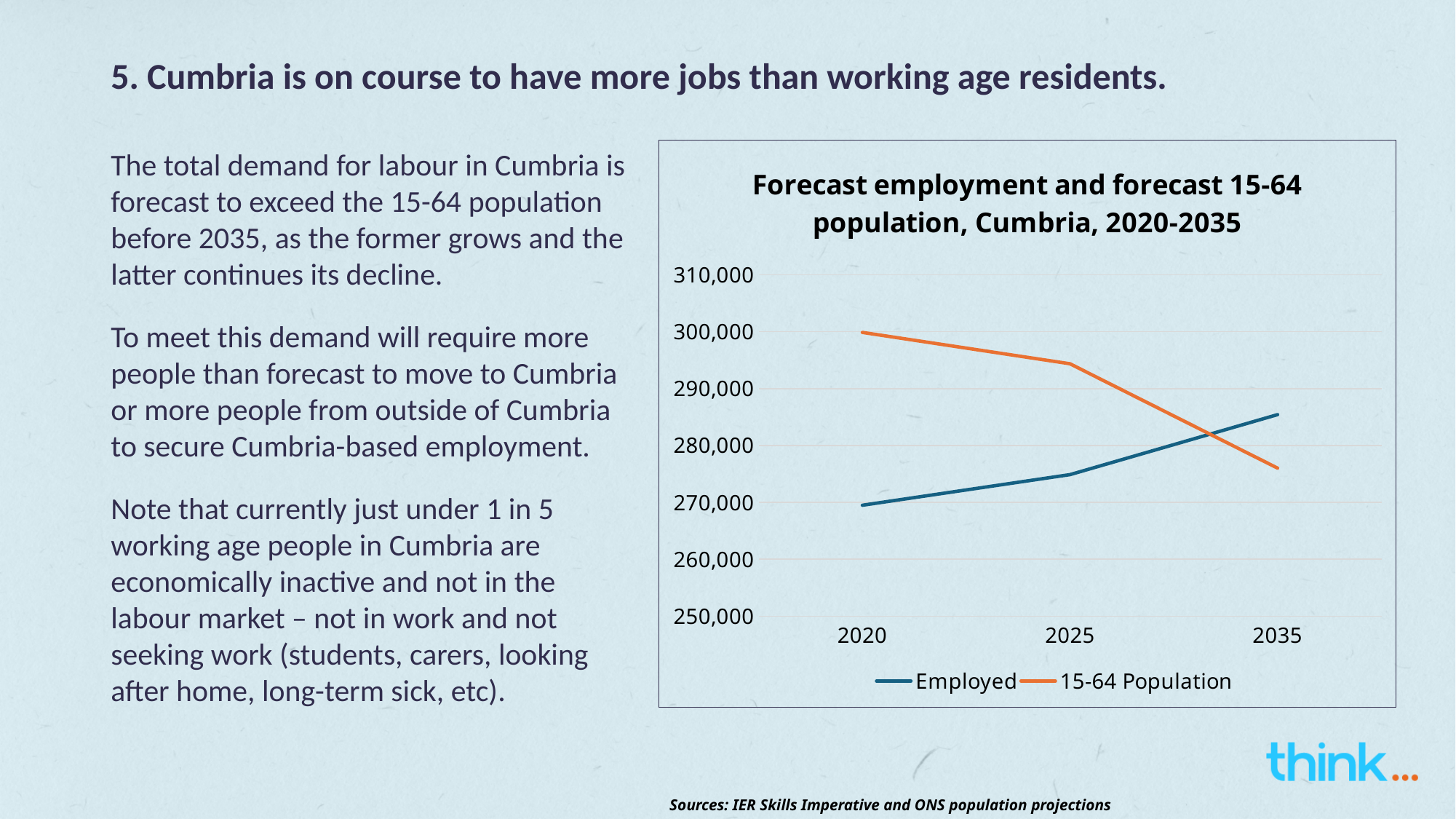
How many series does the chart's legend list? 2 Is the value for Employed in 2025 greater or less than 280,000? less What is the title of the chart? Forecast employment and forecast 15-64 population, Cumbria, 2020-2035 Is the value for Employed in 2035 greater or less than 280,000? greater Is the value for 15-64 Population in 2035 greater or less than 280,000? less In 2035, which series has the higher value, Employed or 15-64 Population? Employed Does the Employed line rise or fall from 2020 to 2035? Rises What kind of chart is shown on the slide? Line chart Does the 15-64 Population line rise or fall from 2020 to 2035? Falls How many years are shown on the x axis of the chart? 3 In 2020, which series has the higher value, Employed or 15-64 Population? 15-64 Population